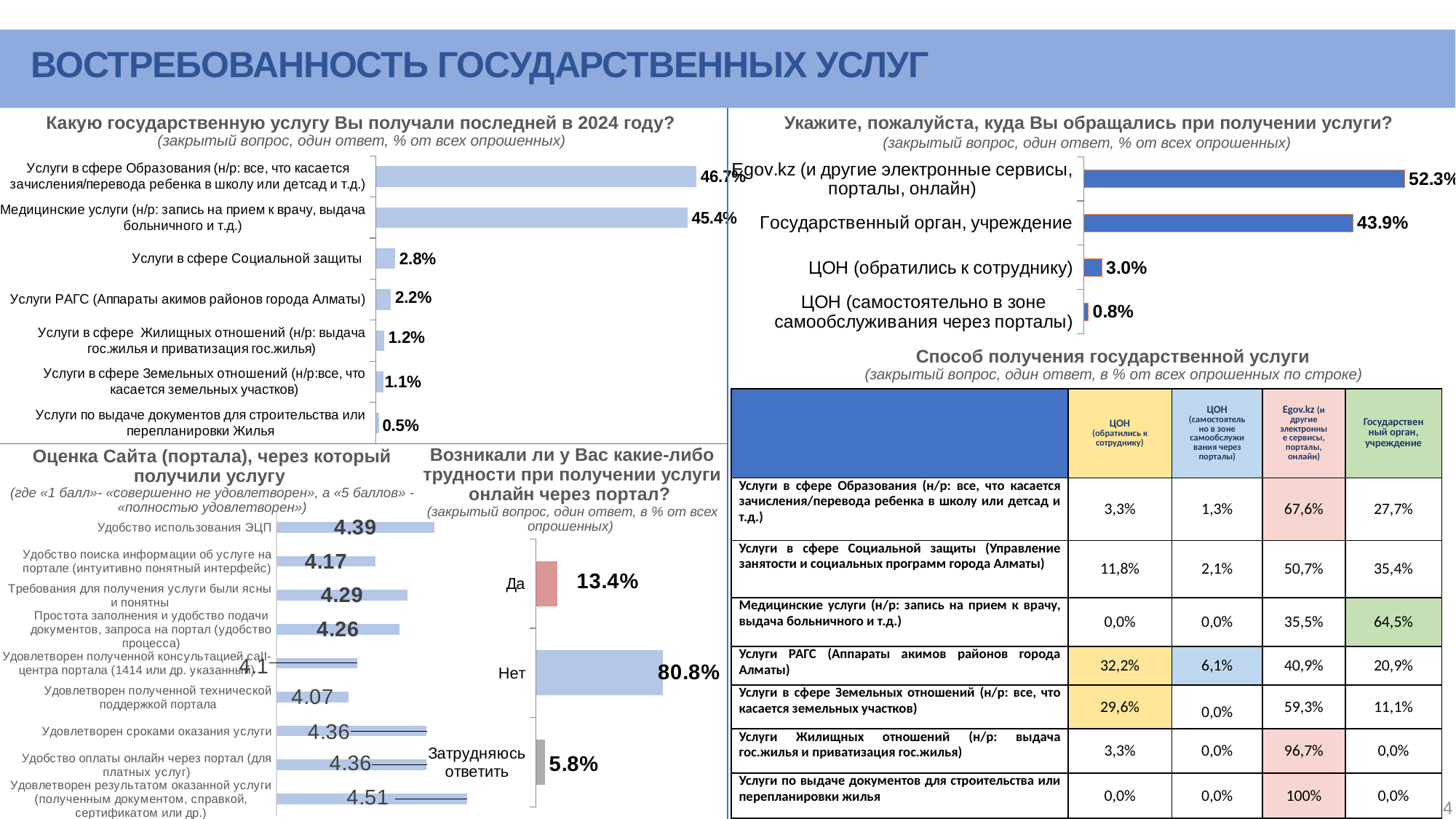
In the chart 'Какую государственную услугу Вы получали последней в 2024 году?', which category has the lowest value? Услуги по выдаче документов для строительства или перепланировки Жилья In the chart 'Какую государственную услугу Вы получали последней в 2024 году?', which category has the highest value? Услуги в сфере Образования In the chart 'Возникали ли у Вас какие-либо трудности при получении услуги онлайн через портал?', what is the value for 'Нет'? 80.8% In the chart 'Укажите, пожалуйста, куда Вы обращались при получении услуги?', which is larger: 'ЦОН (обратились к сотруднику)' or 'ЦОН (самостоятельно в зоне самообслуживания через порталы)'? ЦОН (обратились к сотруднику) How many categories are shown in the chart 'Какую государственную услугу Вы получали последней в 2024 году?'? 7 In the chart 'Какую государственную услугу Вы получали последней в 2024 году?', what is the value for 'Услуги в сфере Социальной защиты'? 2.8% In the chart 'Оценка Сайта (портала), через который получили услугу', what is the score for 'Удобство использования ЭЦП'? 4.39 In the chart 'Укажите, пожалуйста, куда Вы обращались при получении услуги?', what is the value for 'Государственный орган, учреждение'? 43.9% In the chart 'Возникали ли у Вас какие-либо трудности при получении услуги онлайн через портал?', what is the difference between 'Да' and 'Затрудняюсь ответить'? 7.6% In the chart 'Какую государственную услугу Вы получали последней в 2024 году?', what is the difference between the values for 'Услуги в сфере Образования' and 'Медицинские услуги'? 1.3% What type of chart is 'Укажите, пожалуйста, куда Вы обращались при получении услуги?'? Bar chart In the chart 'Оценка Сайта (портала), через который получили услугу', which item has the highest score? Удовлетворен результатом оказанной услуги (полученным документом, справкой, сертификатом или др.)